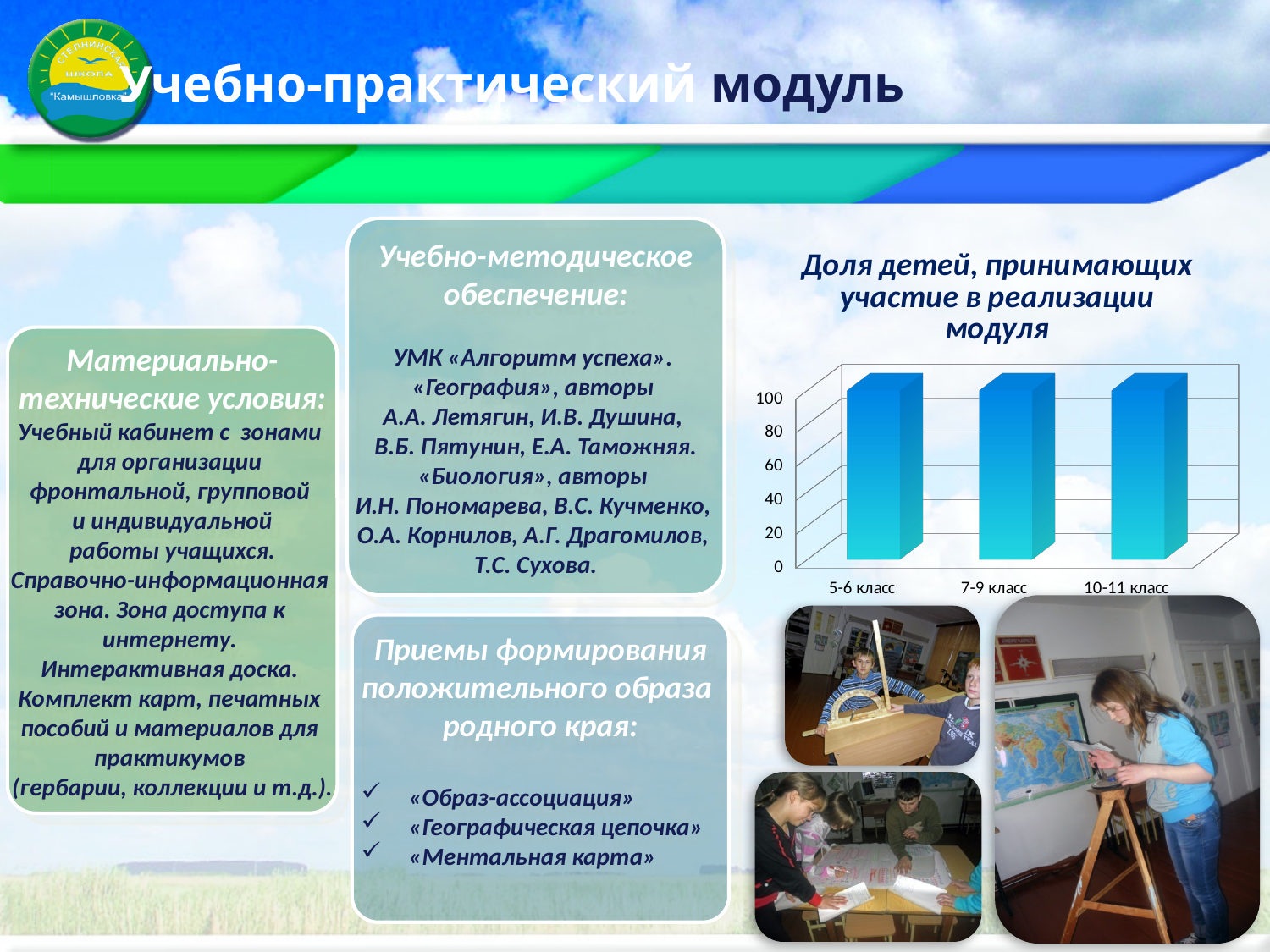
What kind of chart is shown on the slide? bar chart Is the value for 7-9 класс greater or less than 60? greater Is the value for 10-11 класс greater or less than 80? greater Is the value for 5-6 класс greater or less than 80? greater Which category is shown first on the x axis of the chart? 5-6 класс What is the highest tick value shown on the vertical axis of the chart? 100 How many categories are shown on the x axis of the chart? 3 Which category is shown last on the x axis of the chart? 10-11 класс What is the title of the chart? Доля детей, принимающих участие в реализации модуля